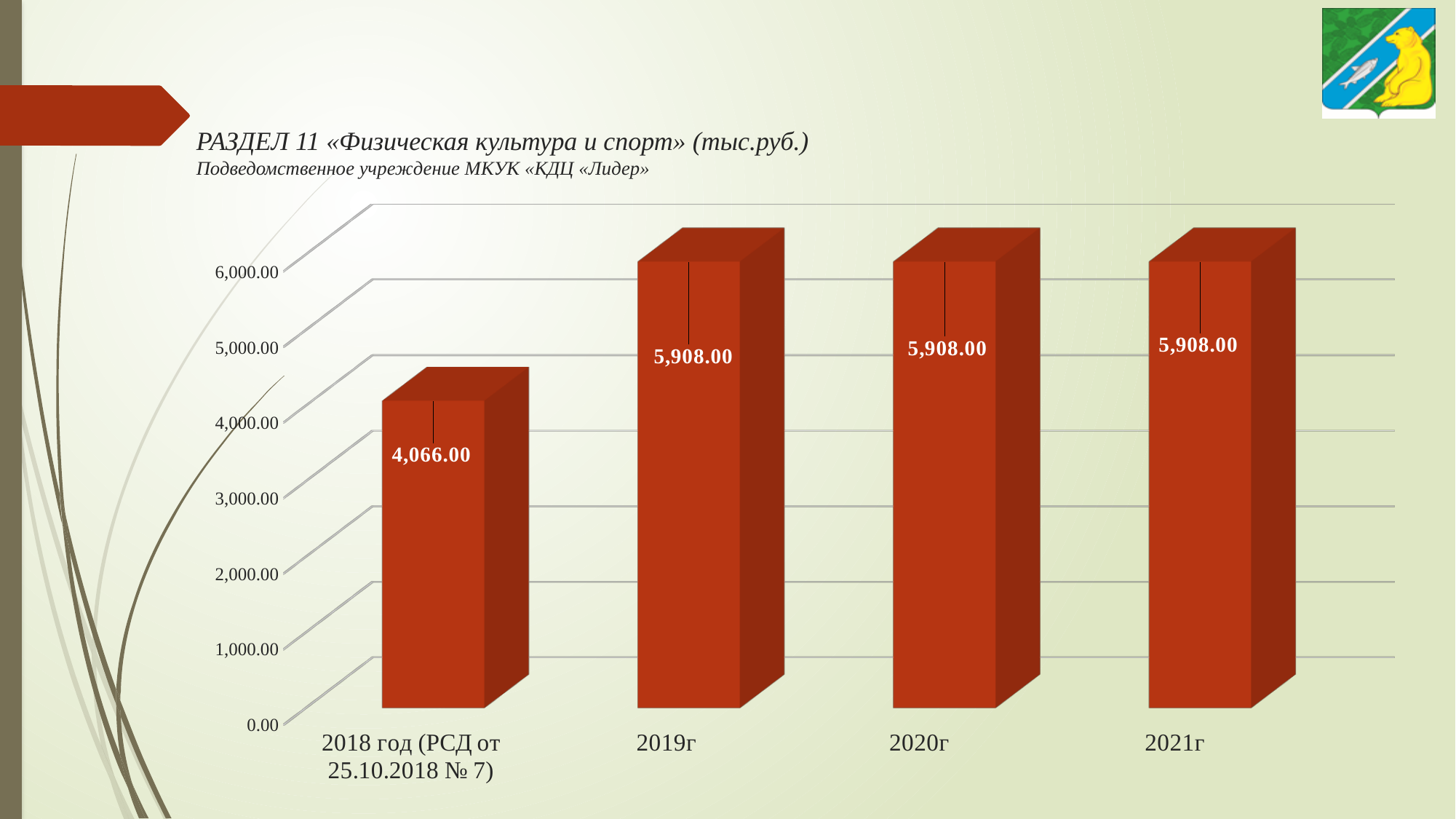
Which category has the lowest value? 2018 год (РСД от 25.10.2018 № 7) What is the value for 2021г? 5,908.00 What is the value for 2019г? 5,908.00 What is the value for 2020г? 5,908.00 Is the value for 2021г greater or less than 5,000.00? greater What kind of chart is shown on the slide? bar chart Does the value rise or fall from 2018 год (РСД от 25.10.2018 № 7) to 2019г? rise Which is larger, the value for 2020г or the value for 2018 год (РСД от 25.10.2018 № 7)? 2020г What is the value for the 2018 год (РСД от 25.10.2018 № 7) category? 4,066.00 How many categories are shown on the x axis? 4 Is the value for 2018 год (РСД от 25.10.2018 № 7) greater or less than 5,000.00? less What is the difference between the values for 2019г and 2018 год (РСД от 25.10.2018 № 7)? 1,842.00